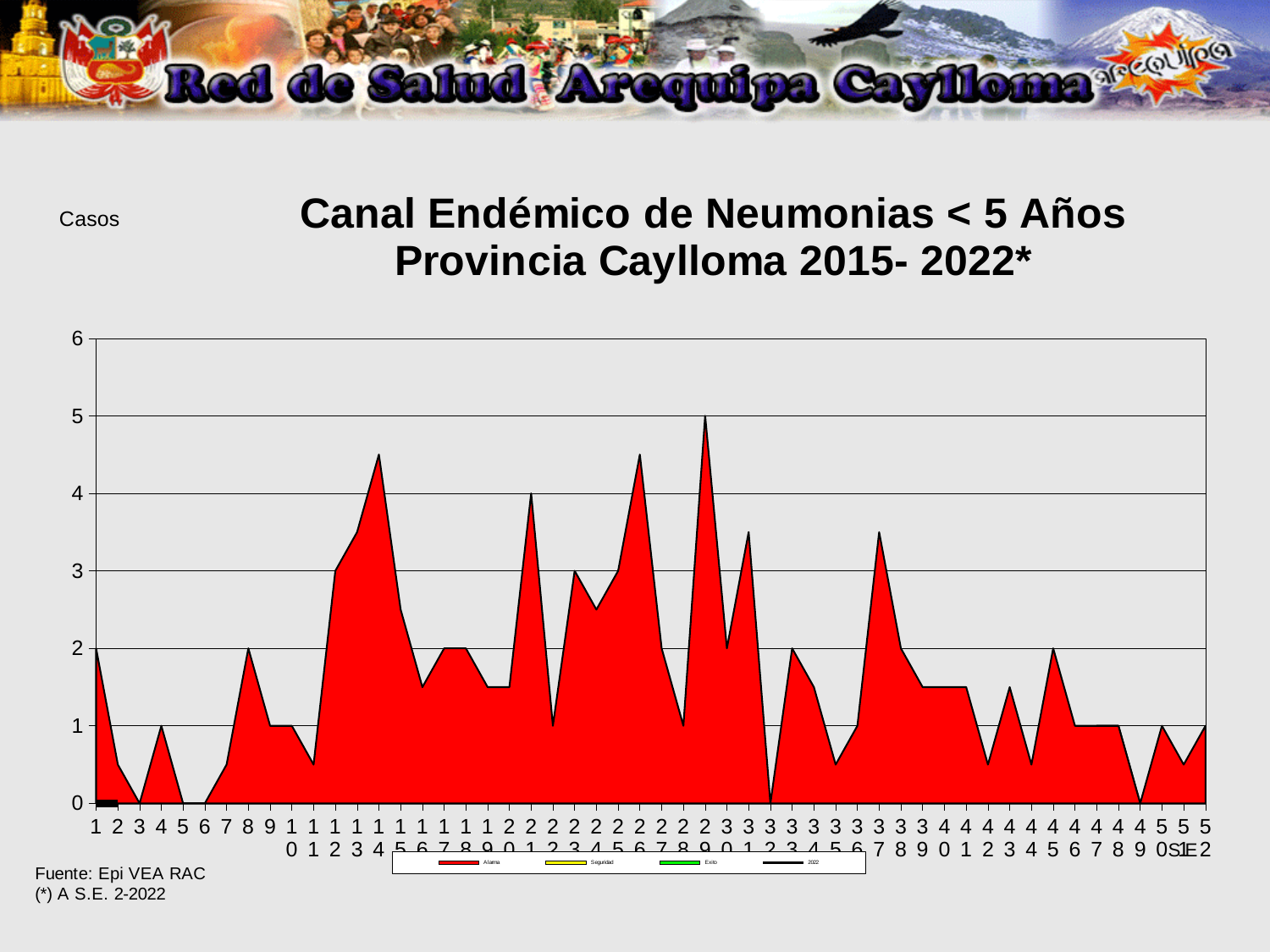
What label is shown on the vertical axis of the chart? Casos Is the value of the Alarma area at week 10 greater or less than 2? less Which is larger, the Alarma value at week 29 or at week 21? Week 29 What is the value of the Alarma area at week 29? 5 What is the value of the Alarma area at week 1? 2 What kind of chart is shown on the slide? Area chart What is the title of the chart? Canal Endémico de Neumonias < 5 Años Provincia Caylloma 2015- 2022* At which week does the red Alarma area reach its highest value? Week 29 Is the value of the Alarma area at week 14 greater or less than 4? greater What is the value of the Alarma area at week 21? 4 How many series does the legend list? 4 How many weeks are plotted along the x axis? 52